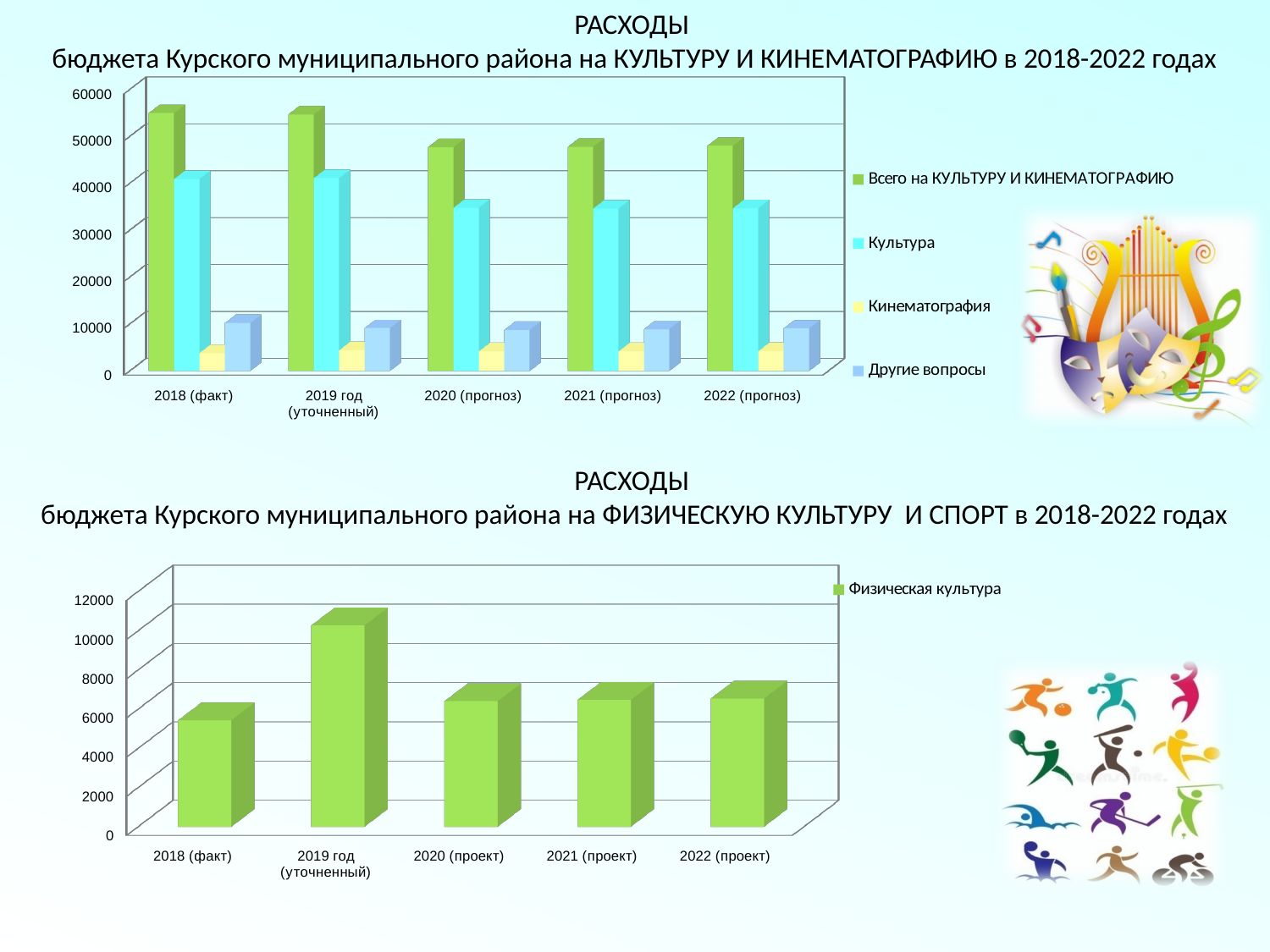
In the top chart (expenses on culture and cinematography), which is larger in 2019 год (уточненный): 'Культура' or 'Другие вопросы'? Культура In the bottom chart (expenses on physical culture and sport), which year has the highest value? 2019 год (уточненный) In the top chart (expenses on culture and cinematography), is the value for 'Культура' in 2020 (прогноз) greater or less than 40000? less In the top chart (expenses on culture and cinematography), what is the legend entry shown in light blue? Культура In the top chart (expenses on culture and cinematography), is the value for 'Всего на КУЛЬТУРУ И КИНЕМАТОГРАФИЮ' in 2018 (факт) greater or less than 50000? greater In the top chart (expenses on culture and cinematography), what kind of chart is it? bar chart In the top chart (expenses on culture and cinematography), how many year categories are shown on the x axis? 5 In the top chart (expenses on culture and cinematography), how many series does the legend list? 4 In the bottom chart (expenses on physical culture and sport), is the value for 2019 год (уточненный) greater or less than 10000? greater In the top chart (expenses on culture and cinematography), which series has the lowest values in every year? Кинематография In the bottom chart (expenses on physical culture and sport), which year has the lowest value? 2018 (факт) In the bottom chart (expenses on physical culture and sport), how many series does the legend list? 1